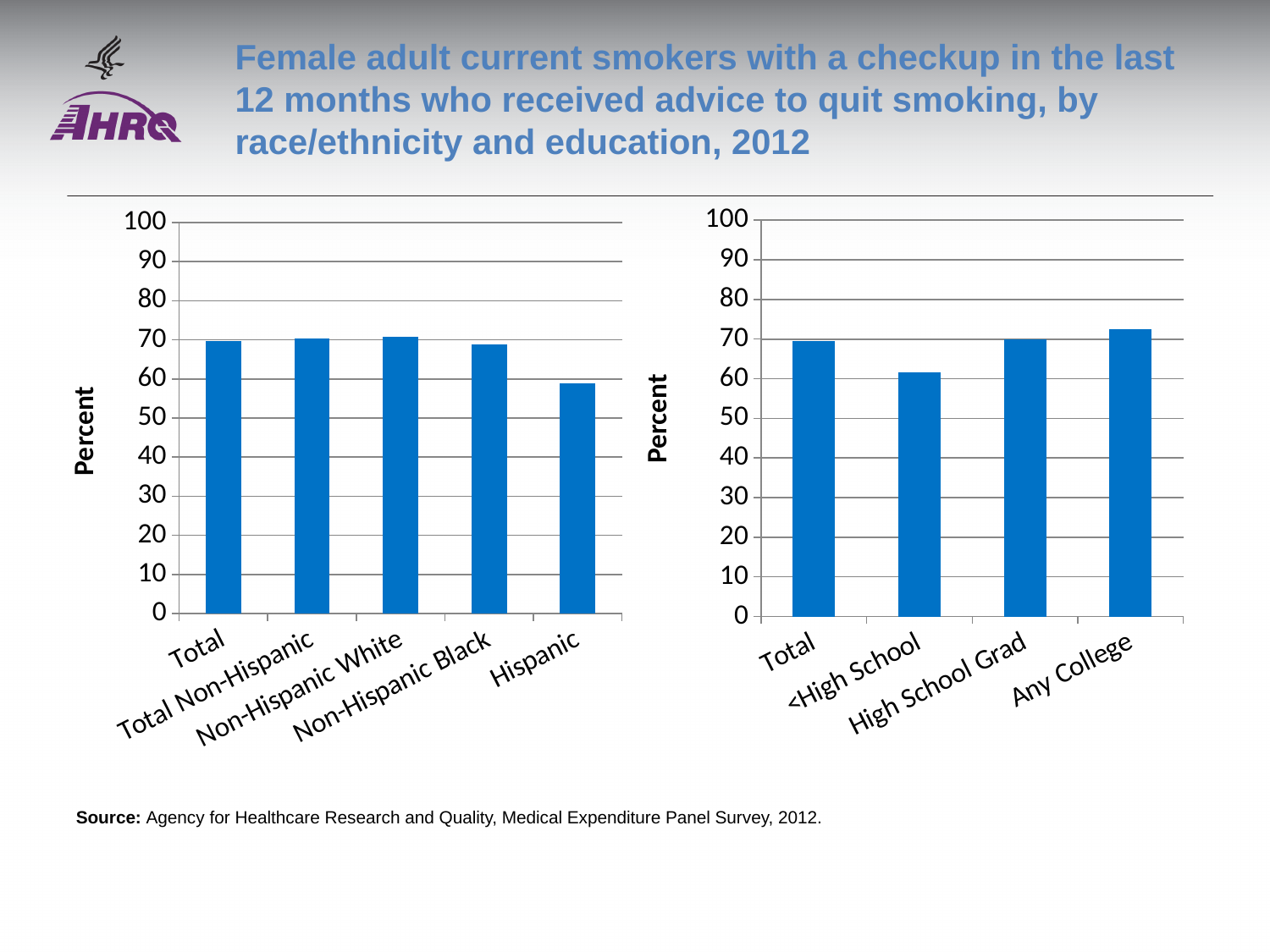
In the left chart (by race/ethnicity), which is larger, the value for Non-Hispanic Black or the value for Hispanic? Non-Hispanic Black How many categories are shown in the right chart (by education)? 4 In the left chart (by race/ethnicity), is the value for Non-Hispanic White greater or less than 60? greater What type of chart is the right chart (by education)? Bar chart In the right chart (by education), which category has the lowest value? <High School In the right chart (by education), which is larger, the value for High School Grad or the value for <High School? High School Grad In the left chart (by race/ethnicity), which category has the lowest value? Hispanic In the right chart (by education), is the value for <High School greater or less than 70? less In the right chart (by education), is the value for Any College greater or less than 70? greater How many categories are shown in the left chart (by race/ethnicity)? 5 In the right chart (by education), which category has the highest value? Any College